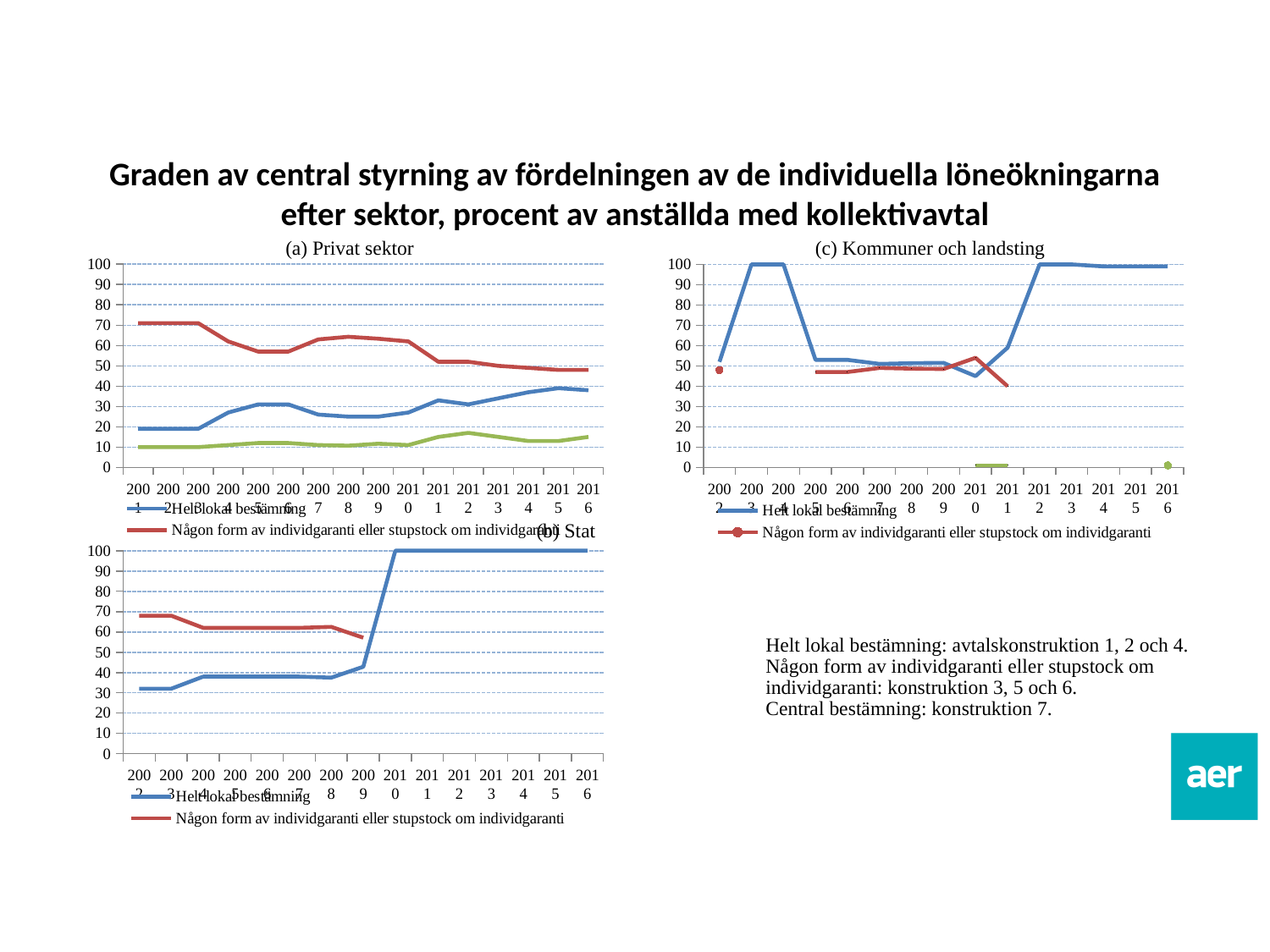
In the chart "(c) Kommuner och landsting", is the value for Någon form av individgaranti eller stupstock om individgaranti in 2011 greater or less than 50? less How many charts are shown on the slide? 3 In the chart "(b) Stat", how many series does the legend list? 2 In the chart "(b) Stat", is the value for Helt lokal bestämning in 2002 greater or less than 50? less In the chart "(a) Privat sektor", is the value for Helt lokal bestämning in 2001 greater or less than 30? less In the chart "(c) Kommuner och landsting", is the value for Helt lokal bestämning larger in 2002 or in 2016? 2016 In the chart "(b) Stat", what is the value for Helt lokal bestämning in 2016? 100 In the chart "(c) Kommuner och landsting", how many series does the legend list? 2 What kind of chart is the chart titled "(a) Privat sektor"? line chart In the chart "(a) Privat sektor", which series has the larger value in 2001: Helt lokal bestämning or Någon form av individgaranti eller stupstock om individgaranti? Någon form av individgaranti eller stupstock om individgaranti In the chart "(a) Privat sektor", does the line for Någon form av individgaranti eller stupstock om individgaranti generally rise or fall from 2001 to 2016? fall